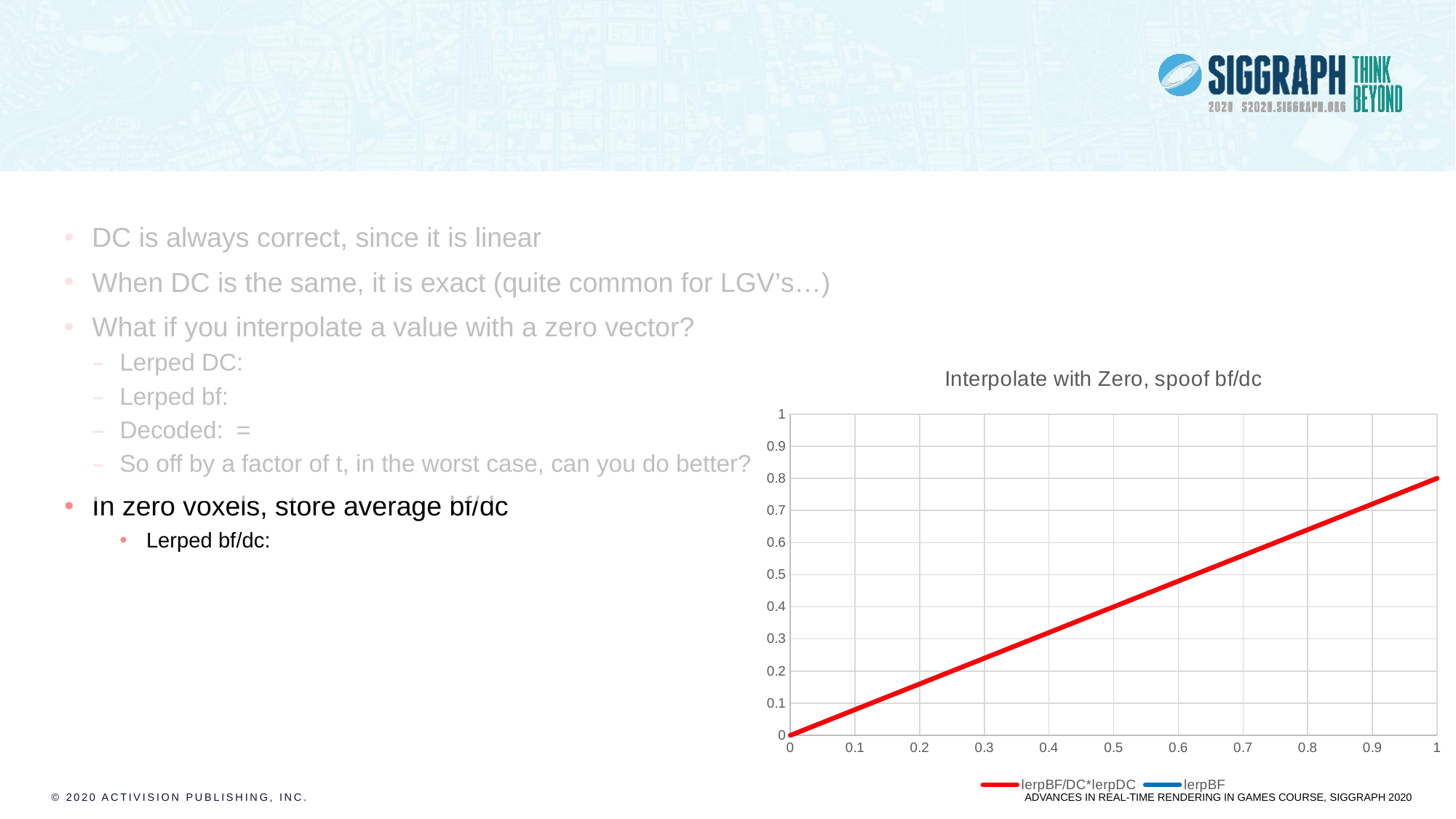
Is the value of the lerpBF/DC*lerpDC line at x = 0.9 greater or less than 0.6? greater Is the value of the lerpBF/DC*lerpDC line at x = 0.2 greater or less than 0.3? less What is the value of the lerpBF/DC*lerpDC line at x = 0? 0 What is the title of the chart? Interpolate with Zero, spoof bf/dc What is the value of the lerpBF/DC*lerpDC line at x = 1? 0.8 Which series is drawn in red in the chart? lerpBF/DC*lerpDC What kind of chart is shown on the slide? line chart Does the lerpBF/DC*lerpDC line rise or fall as x increases from 0 to 1? rise What is the maximum value shown on the chart's y axis? 1 Is the value of the lerpBF/DC*lerpDC line at x = 0.5 greater or less than 0.5? less Is the lerpBF/DC*lerpDC value at x = 0.8 larger or smaller than its value at x = 0.3? larger How many series does the chart legend list? 2